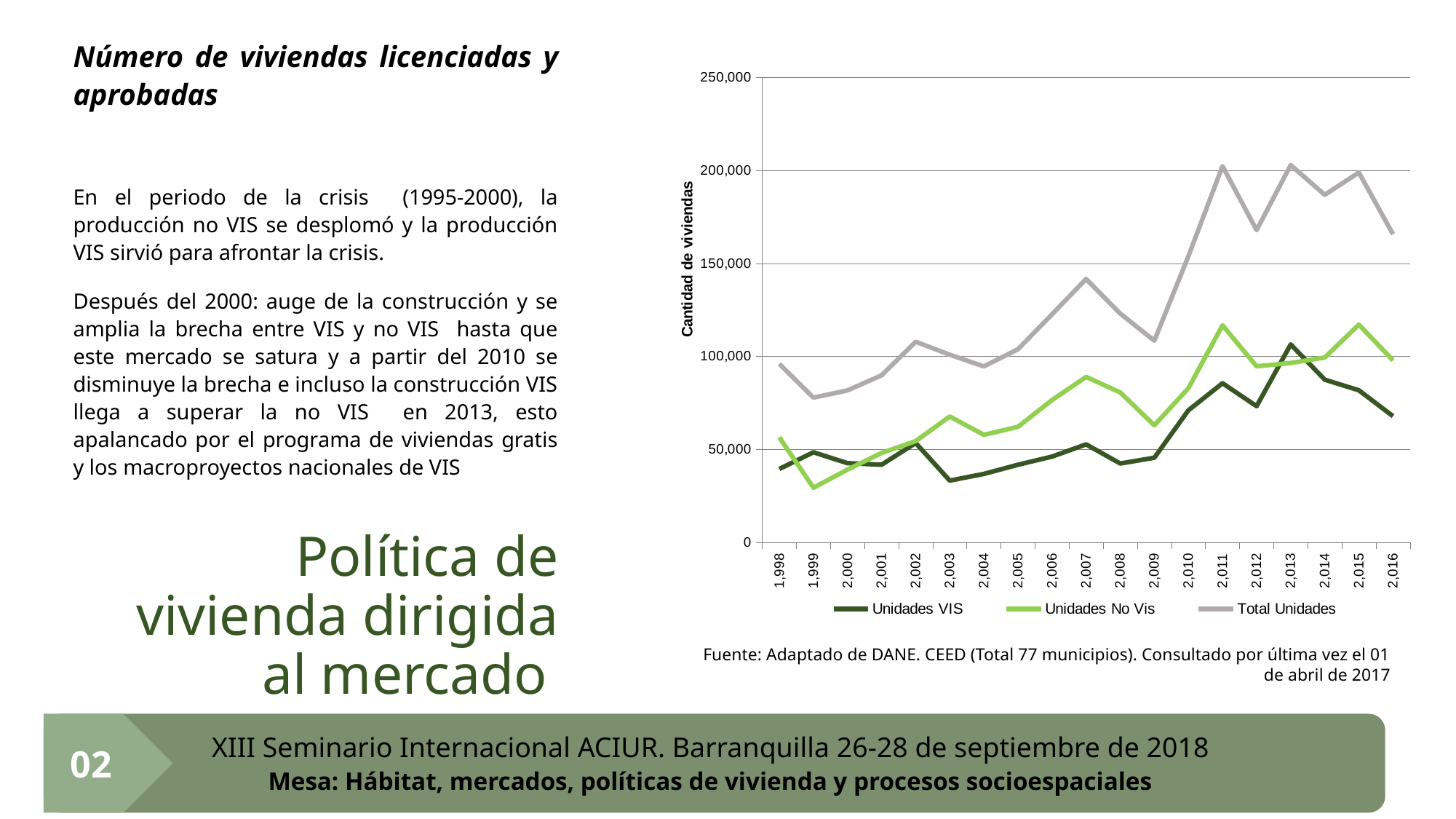
What is the label on the chart's vertical axis? Cantidad de viviendas What kind of chart is shown on the slide? line chart In which year does the Unidades VIS series reach its lowest value? 2003 Is the value of Unidades No Vis in 2015 greater or less than 100,000? greater In 2016, which series is higher: Unidades VIS or Unidades No Vis? Unidades No Vis How many series does the chart's legend list? 3 In which year does the Unidades No Vis series reach its lowest value? 1999 In 2013, which series is higher: Unidades VIS or Unidades No Vis? Unidades VIS In which year does the Unidades VIS series reach its highest value? 2013 Is the value of Total Unidades in 2016 greater or less than 150,000? greater Is the value of Total Unidades in 2007 greater or less than 150,000? less How many years are plotted along the x axis of the chart? 19